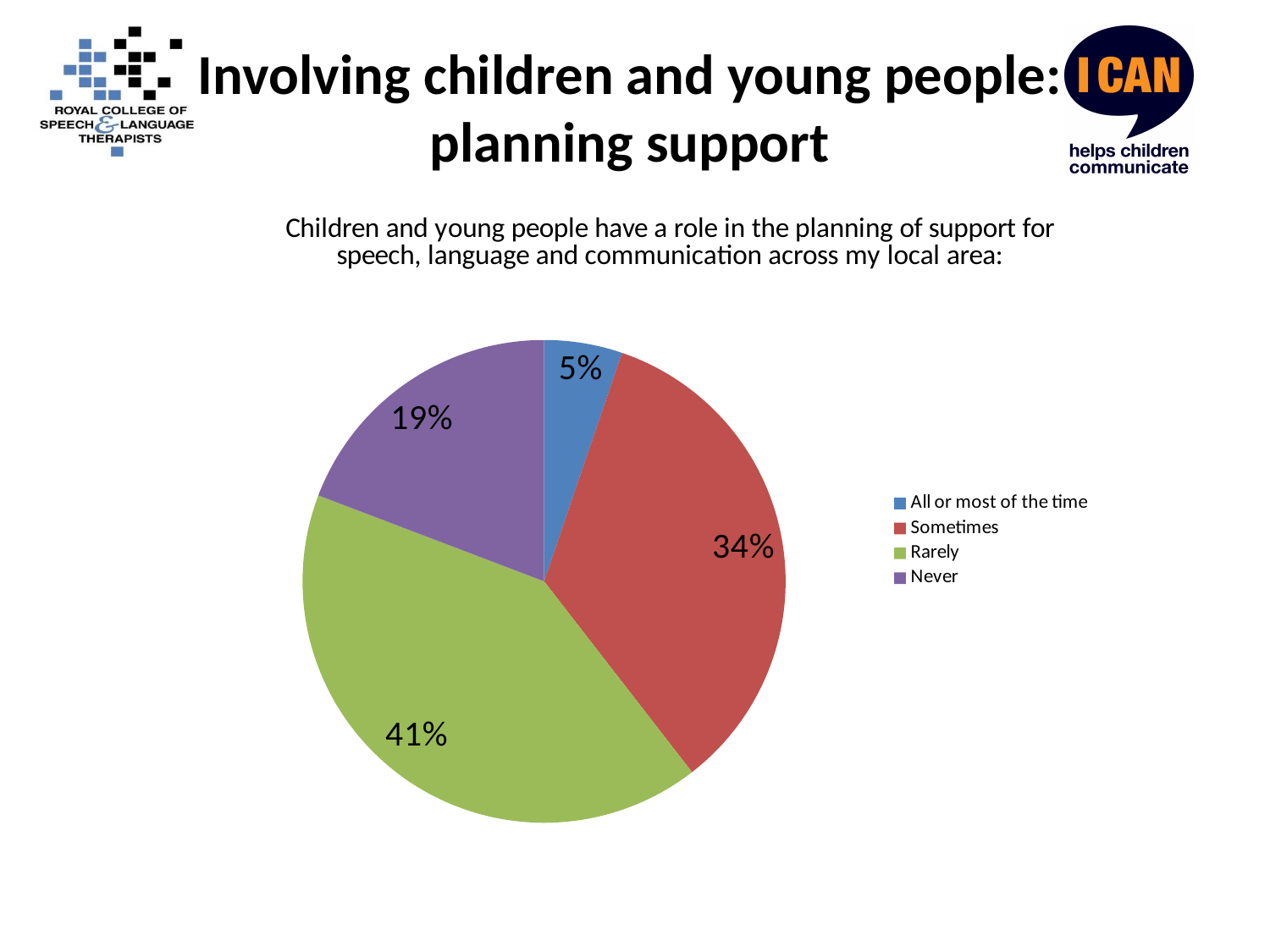
Which category has the smallest slice of the pie? All or most of the time How many categories does the pie chart show? 4 What colour is the "Rarely" slice? green Which slice is larger, "Never" or "Sometimes"? Sometimes What kind of chart is shown on the slide? pie chart What is the difference in percentage points between the "Rarely" and "Sometimes" slices? 7 What is the combined share of the "Rarely" and "Never" slices? 60% Which category has the largest slice of the pie? Rarely What share of the pie is labelled "Never"? 19% What share of the pie is labelled "Rarely"? 41% What share of the pie is labelled "Sometimes"? 34%